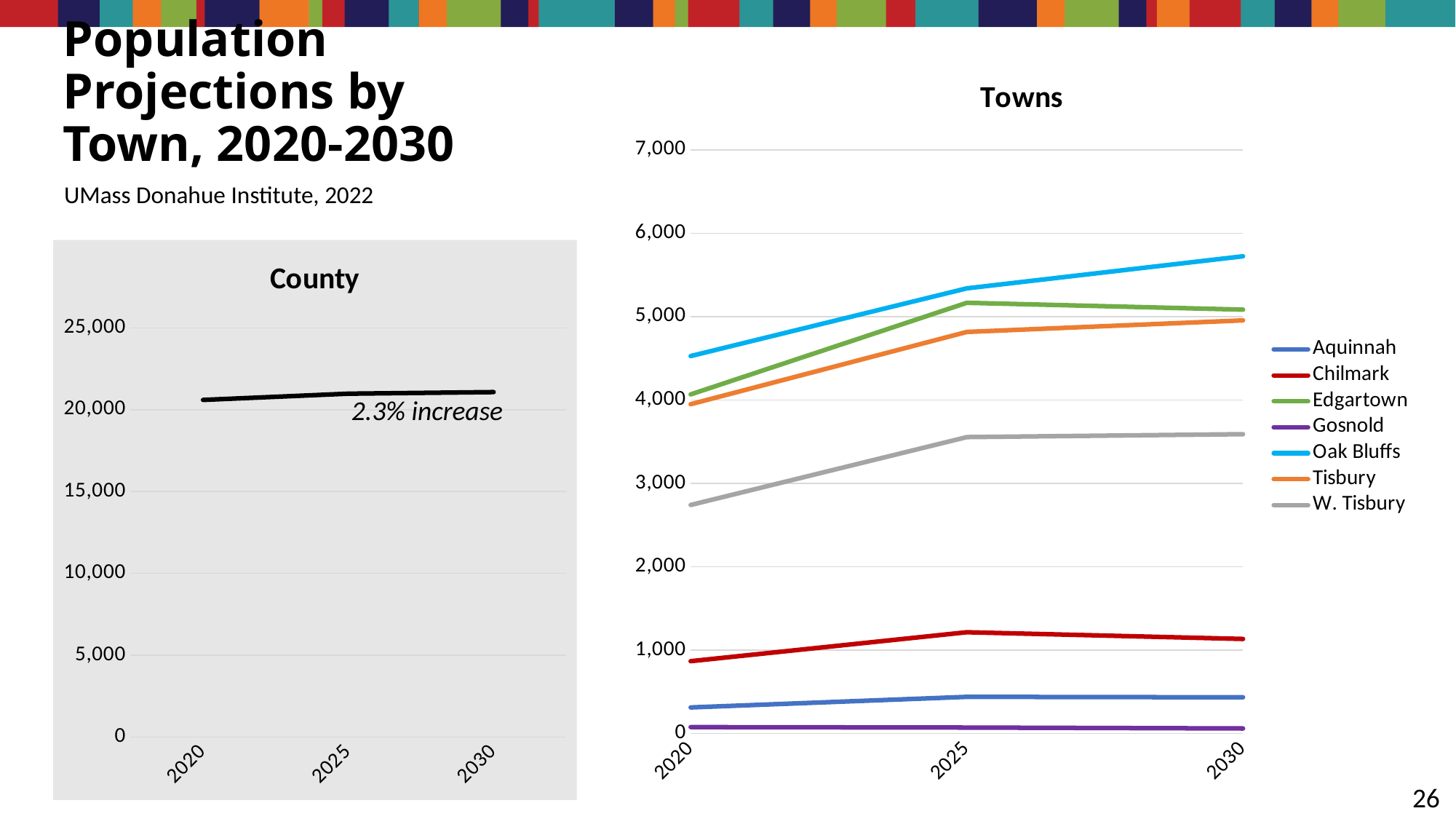
What kind of chart is the Towns chart? line chart In the County chart, is the value for 2020 greater or less than 20,000? greater In the Towns chart, does the Oak Bluffs line rise or fall from 2020 to 2030? rise In the Towns chart, is the value for Chilmark in 2025 greater or less than 1,000? greater How many years are plotted on the x axis of the Towns chart? 3 How many series does the legend of the Towns chart list? 7 In the Towns chart, which town has the lowest projected population? Gosnold In the Towns chart, is the value for Oak Bluffs in 2030 greater or less than 5,000? greater In the Towns chart, which is larger in 2030: Edgartown or Tisbury? Edgartown What percentage increase is annotated on the County chart? 2.3% increase In the Towns chart, which town has the highest projected population across the period? Oak Bluffs